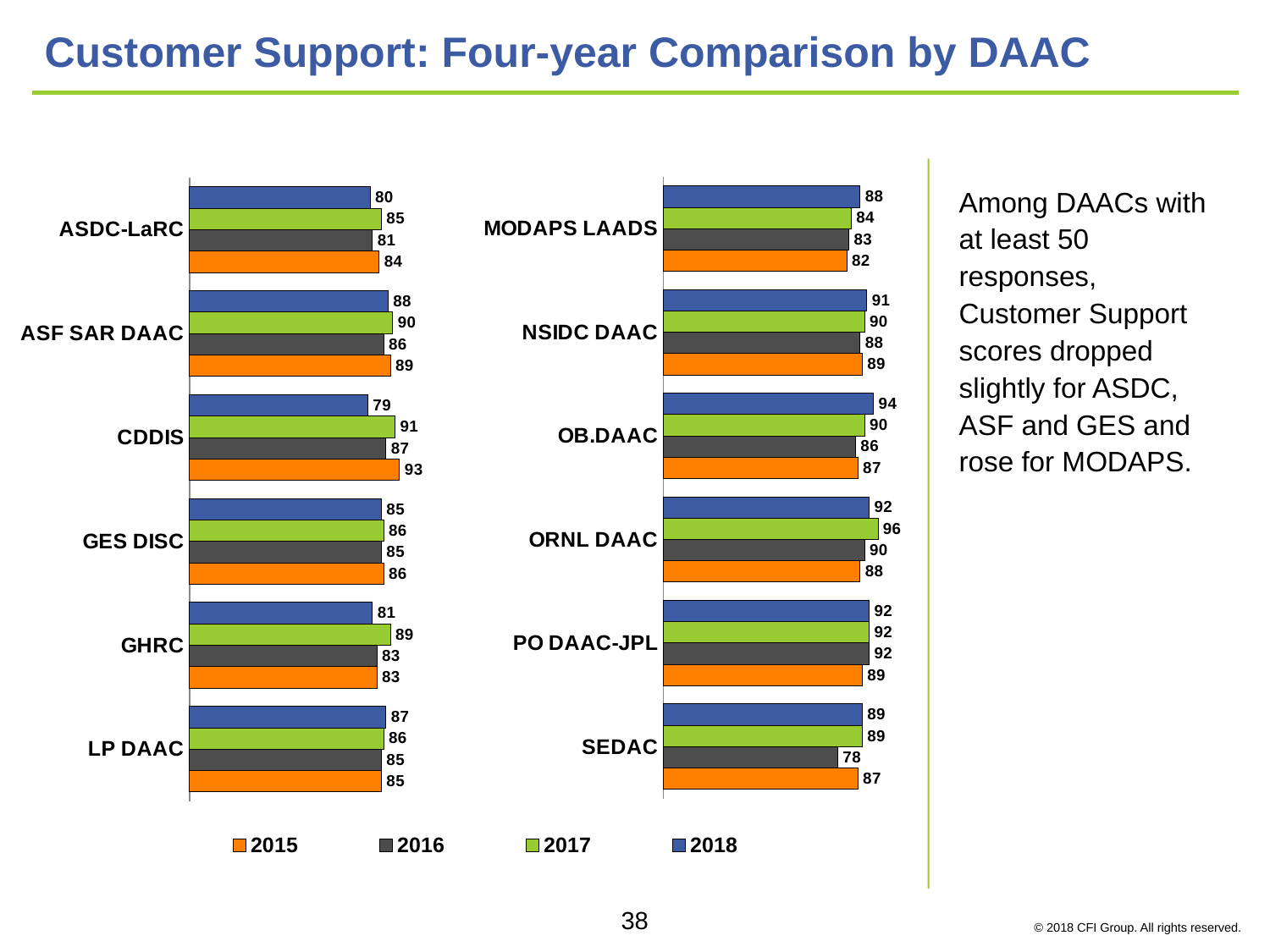
On the right chart, which DAAC has the lowest 2016 value? SEDAC On the left chart, what is the difference between the 2015 and 2018 values for CDDIS? 14 On the right chart, which DAAC has the highest 2018 value? OB.DAAC On the right chart, what is the 2017 value for ORNL DAAC? 96 On the right chart, what is the 2015 value for SEDAC? 87 On the left chart, which is larger: the 2018 value for ASF SAR DAAC or the 2018 value for ASDC-LaRC? ASF SAR DAAC On the right chart, what is the difference between the 2018 and 2015 values for MODAPS LAADS? 6 How many series does the legend list? 4 On the left chart, what is the 2017 value for GHRC? 89 On the left chart, what is the 2018 value for CDDIS? 79 What kind of chart is used on this slide? Bar chart How many DAACs are shown on the left chart? 6